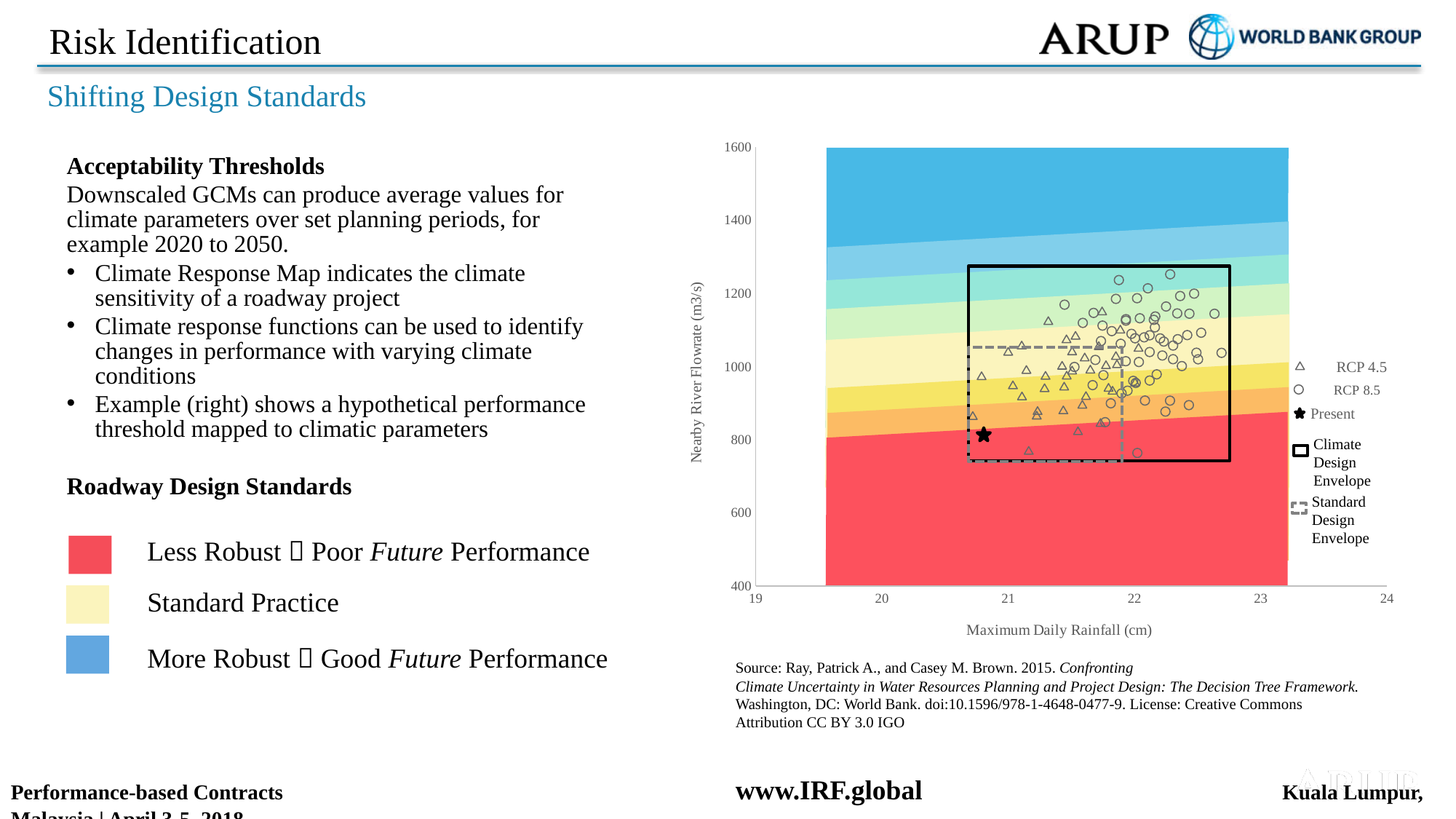
Is the Nearby River Flowrate value for the Present point greater or less than 1000? less What is the label of the chart's y axis? Nearby River Flowrate (m3/s) Is the Maximum Daily Rainfall value for the Present point greater or less than 21? less What kind of chart is shown on the right of the slide? scatter chart How many entries does the chart's legend list? 5 Is the highest RCP 8.5 point's Nearby River Flowrate greater or less than 1200? greater Which series has more plotted points, RCP 4.5 or RCP 8.5? RCP 8.5 What is the label of the chart's x axis? Maximum Daily Rainfall (cm)